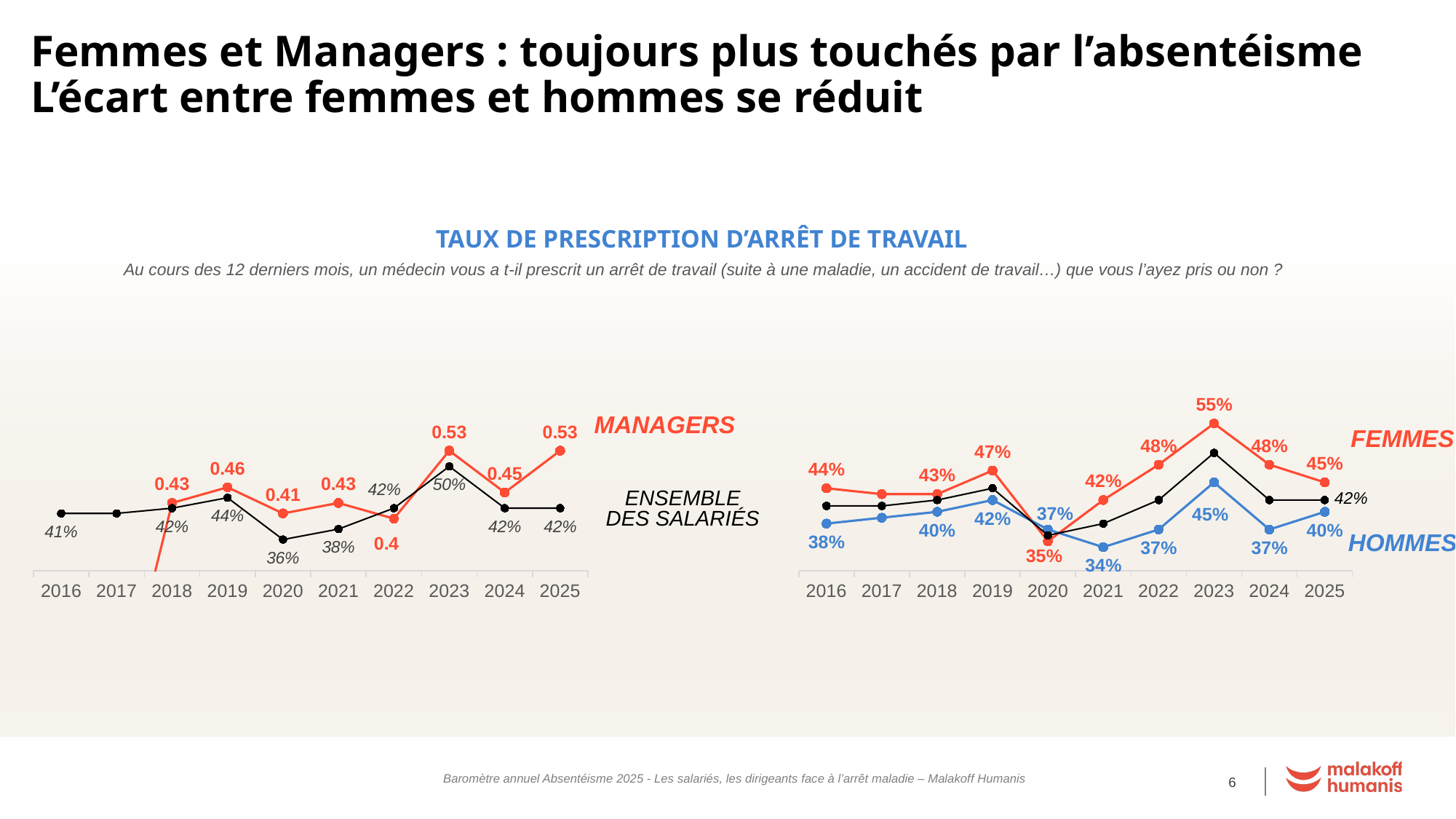
In the right chart, does the Femmes value rise or fall from 2024 to 2025? Fall In the left chart, how many years are shown on the x axis? 10 In the right chart, what is the value for Hommes in 2021? 34% What is the title shown above the two charts? TAUX DE PRESCRIPTION D'ARRÊT DE TRAVAIL In the right chart, what is the difference between the Femmes and Hommes values in 2023? 10% In the left chart, what is the value for Managers in 2023? 0.53 In the right chart, what is the value for Femmes in 2023? 55% In the right chart, in which year is the Femmes value lowest? 2020 What type of chart is the right chart? Line chart In the left chart, which is larger in 2024: the Managers value or the Ensemble des salariés value? Managers In the right chart, in which year is the Hommes value highest? 2023 In the left chart, what is the value for Ensemble des salariés in 2020? 36%